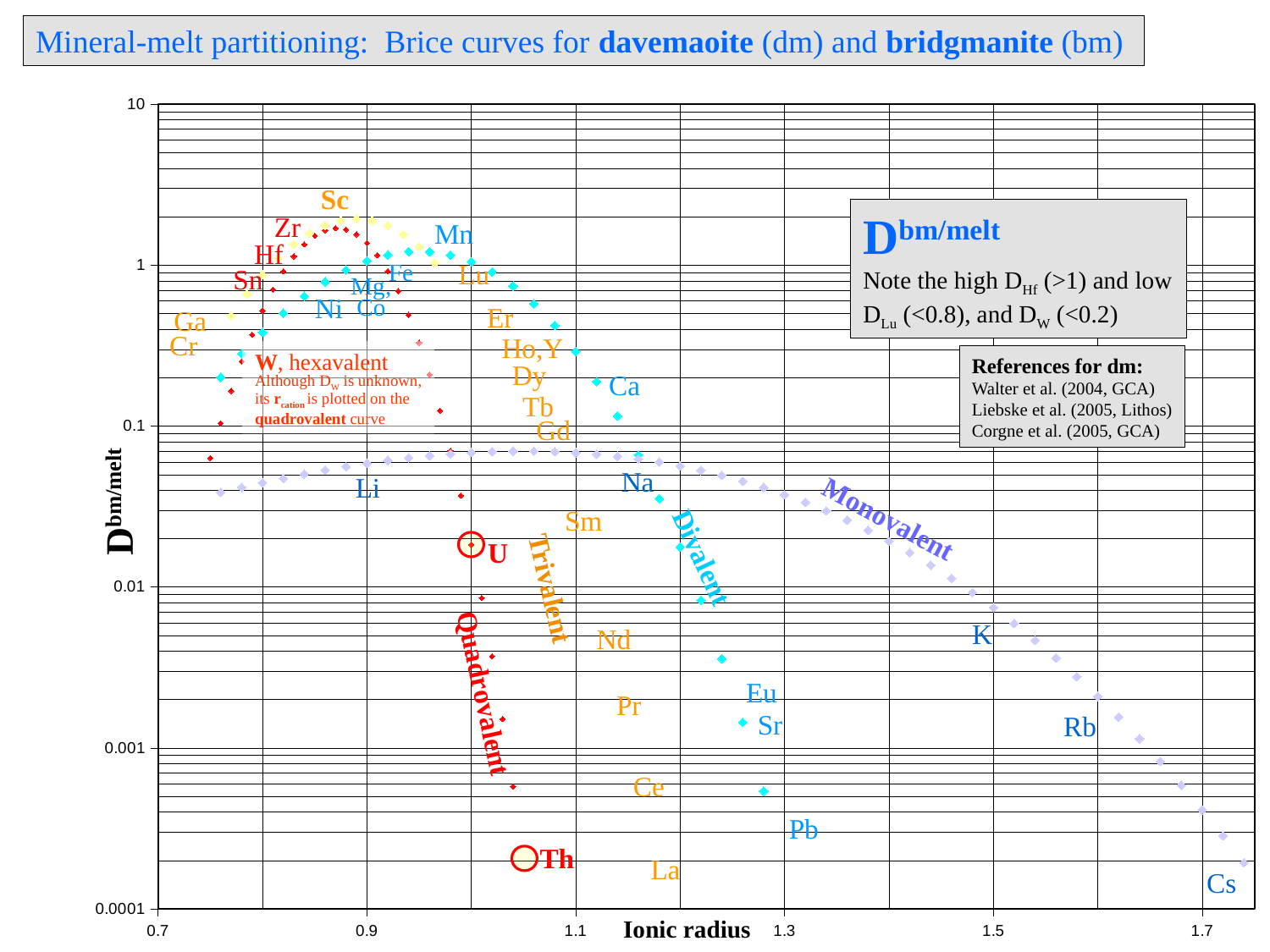
Is the value for K greater or less than 0.01? less Is the value for U greater or less than 0.01? greater What is the label of the y axis? D bm/melt Is the value for Th greater or less than 0.001? less Which has the larger value, Hf or Cs? Hf Along the monovalent curve, do the values rise or fall as ionic radius increases from Na to Cs? fall What kind of chart is shown on the slide? scatter chart What is the label of the x axis? Ionic radius